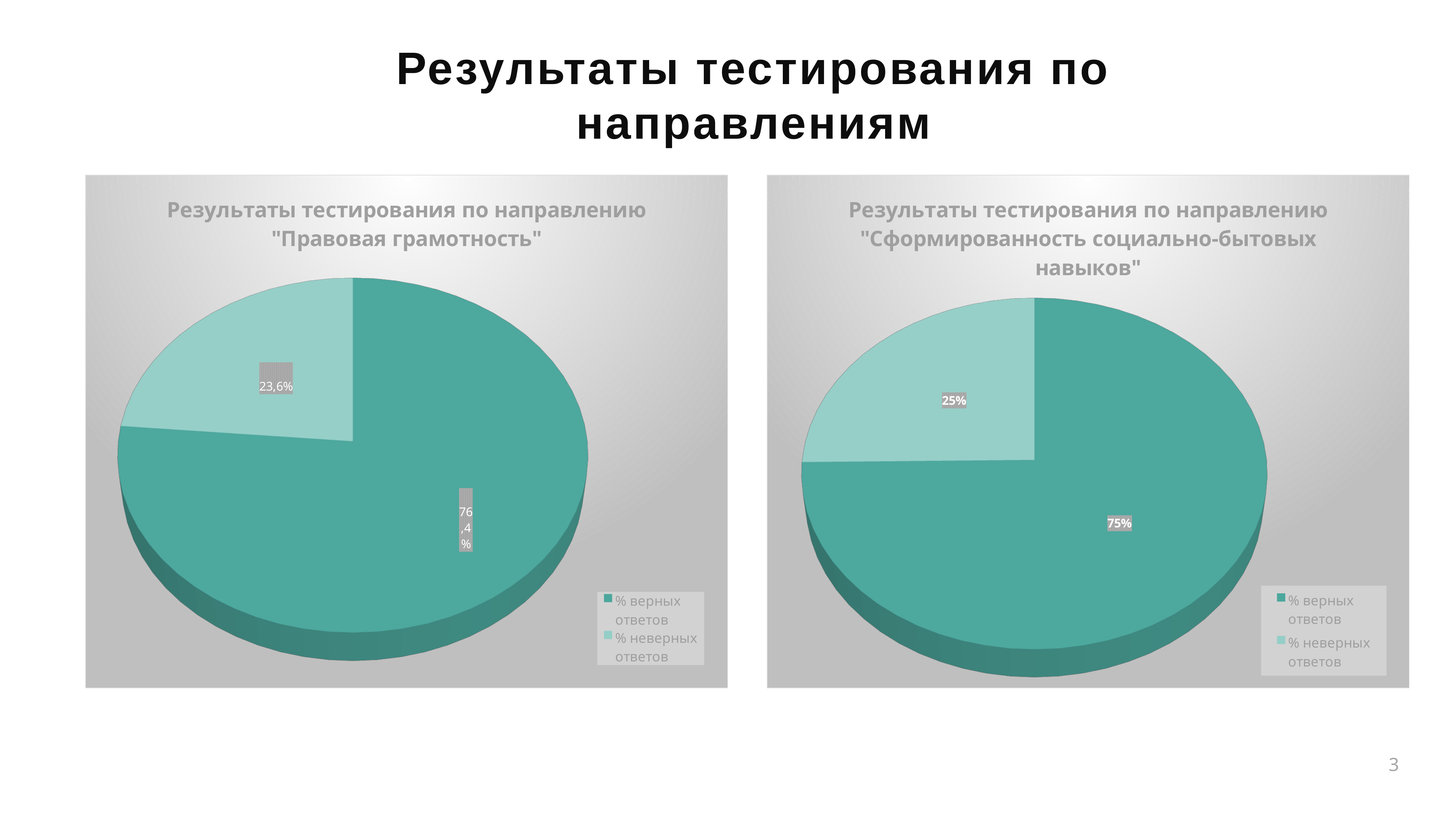
What type of chart is used in the left chart ("Правовая грамотность")? Pie chart In the left chart ("Правовая грамотность"), what share of answers were incorrect (% неверных ответов)? 23,6% Which chart shows a higher share of correct answers: the left one ("Правовая грамотность") or the right one ("Сформированность социально-бытовых навыков")? The left one ("Правовая грамотность") In the right chart ("Сформированность социально-бытовых навыков"), what share of answers were incorrect (% неверных ответов)? 25% In the left chart ("Правовая грамотность"), which slice is the largest? % верных ответов In the right chart ("Сформированность социально-бытовых навыков"), what is the difference between the share of correct and incorrect answers? 50% In the left chart ("Правовая грамотность"), what share of answers were correct (% верных ответов)? 76,4% In the right chart ("Сформированность социально-бытовых навыков"), what share of answers were correct (% верных ответов)? 75% In the right chart ("Сформированность социально-бытовых навыков"), which slice is the smallest? % неверных ответов How many slices does the right chart ("Сформированность социально-бытовых навыков") have? 2 In the left chart ("Правовая грамотность"), what is the difference between the share of correct and incorrect answers? 52,8% How many entries does the legend of the left chart ("Правовая грамотность") list? 2